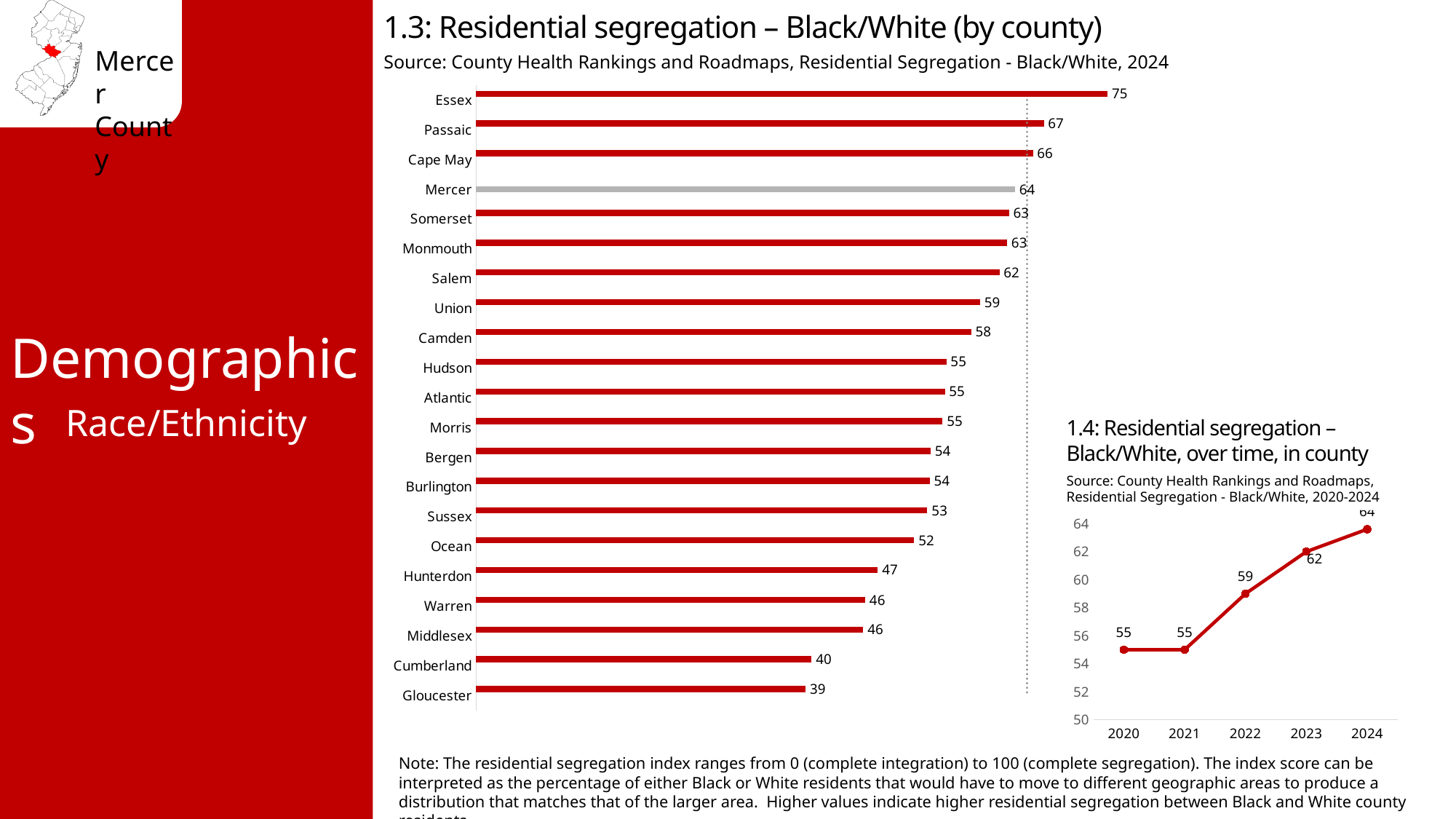
In chart 1.4 (Residential segregation over time in county), what is the value for 2023? 62 In chart 1.3 (Residential segregation – Black/White by county), what is the value for Mercer? 64 What kind of chart is chart 1.3 (Residential segregation – Black/White by county)? Bar chart In chart 1.3 (by county), what is the difference between the values for Essex and Passaic? 8 In chart 1.3 (by county), what is the value for Gloucester? 39 In chart 1.4 (over time), what is the value for 2020? 55 In chart 1.3 (by county), how many counties are shown? 21 In chart 1.3 (by county), which has a larger value, Hunterdon or Cumberland? Hunterdon In chart 1.4 (over time), do the values rise or fall from 2021 to 2024? Rise In chart 1.4 (over time), what is the difference between the values for 2022 and 2021? 4 In chart 1.3 (by county), which county has the highest residential segregation index? Essex In chart 1.3 (by county), which county has the lowest residential segregation index? Gloucester